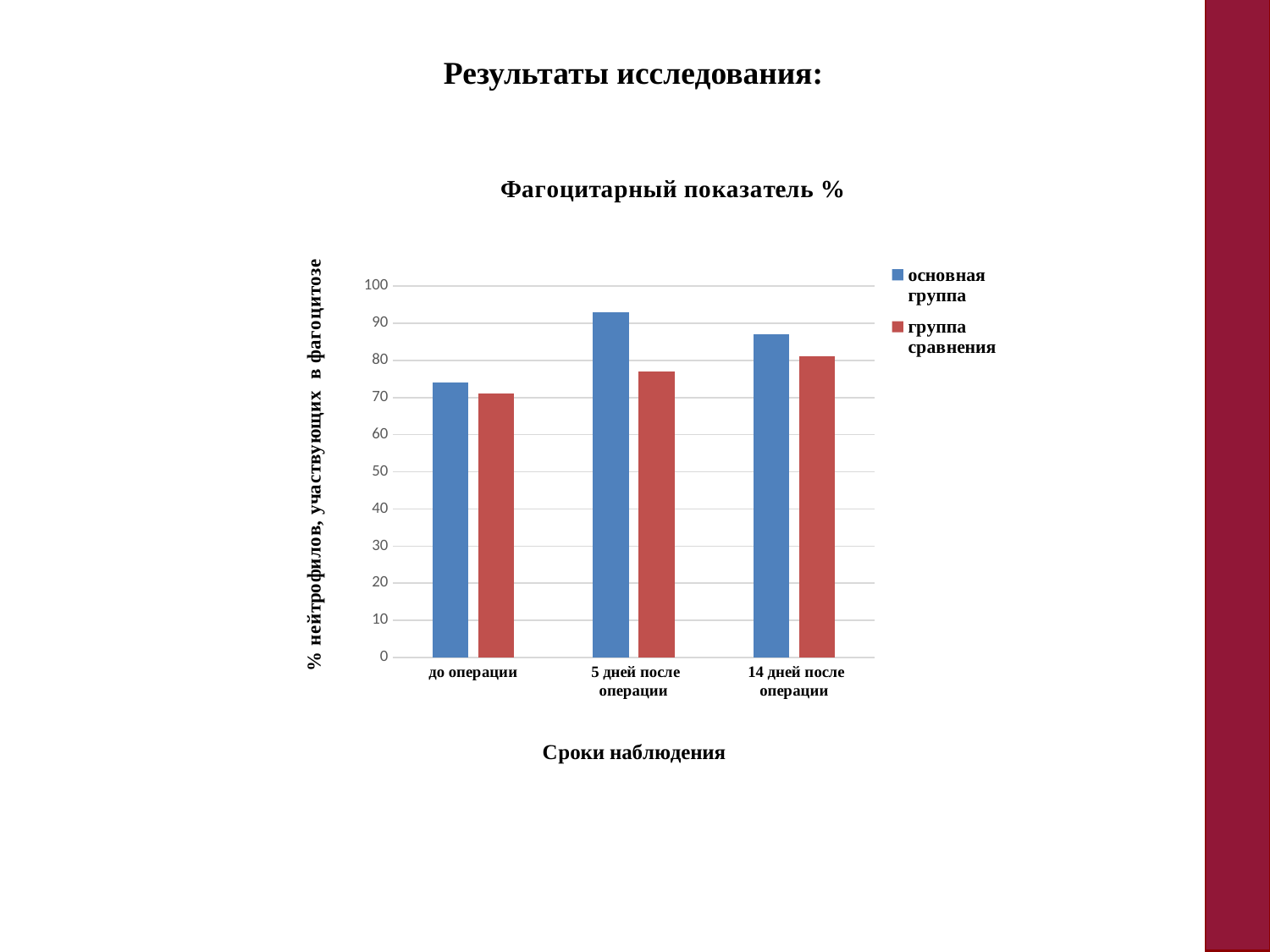
For which category is the value of основная группа highest? 5 дней после операции What is the x-axis title of the chart? Сроки наблюдения What kind of chart is shown on the slide? bar chart Is the value for основная группа at 5 дней после операции greater or less than 90? greater For which category is the value of группа сравнения highest? 14 дней после операции At 5 дней после операции, which series has the larger value, основная группа or группа сравнения? основная группа How many categories are shown on the x axis? 3 For which category is the value of основная группа lowest? до операции How many series does the legend list? 2 Do the values for группа сравнения rise or fall from до операции to 14 дней после операции? rise What is the title of the chart? Фагоцитарный показатель % Is the value for группа сравнения at 5 дней после операции greater or less than 80? less